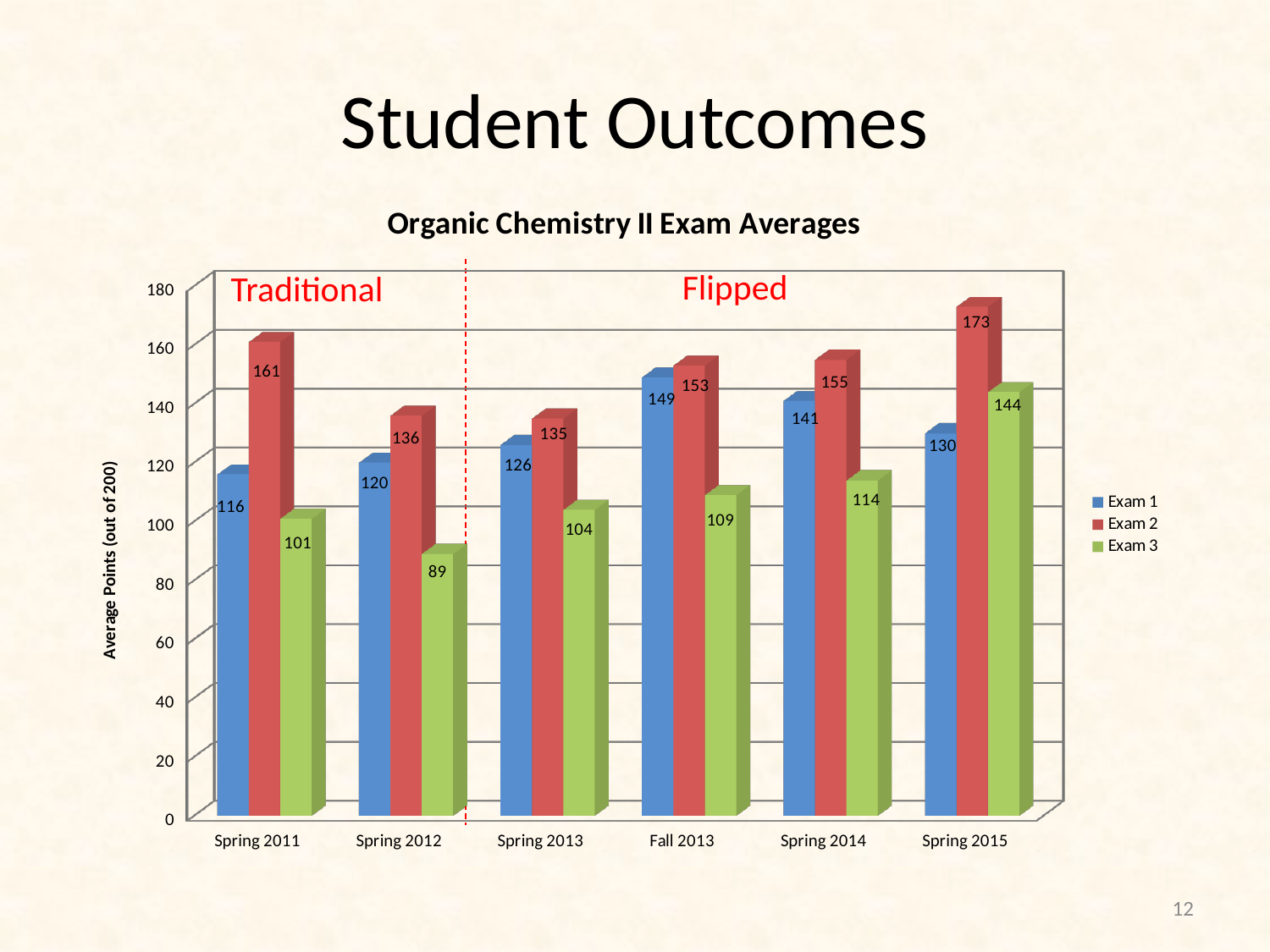
What is the label on the vertical axis? Average Points (out of 200) What is the Exam 2 average for Spring 2015? 173 What is the Exam 1 average for Fall 2013? 149 What is the title of the chart? Organic Chemistry II Exam Averages Which semester has the lowest Exam 1 average? Spring 2011 How many series does the legend list? 3 What is the Exam 3 average for Spring 2012? 89 How many semesters are shown on the x axis? 6 Which semester has the highest Exam 3 average? Spring 2015 What is the difference between the Exam 2 and Exam 3 averages for Spring 2011? 60 What kind of chart is shown? Bar chart Which is larger, the Exam 1 average for Spring 2014 or the Exam 1 average for Spring 2015? Spring 2014